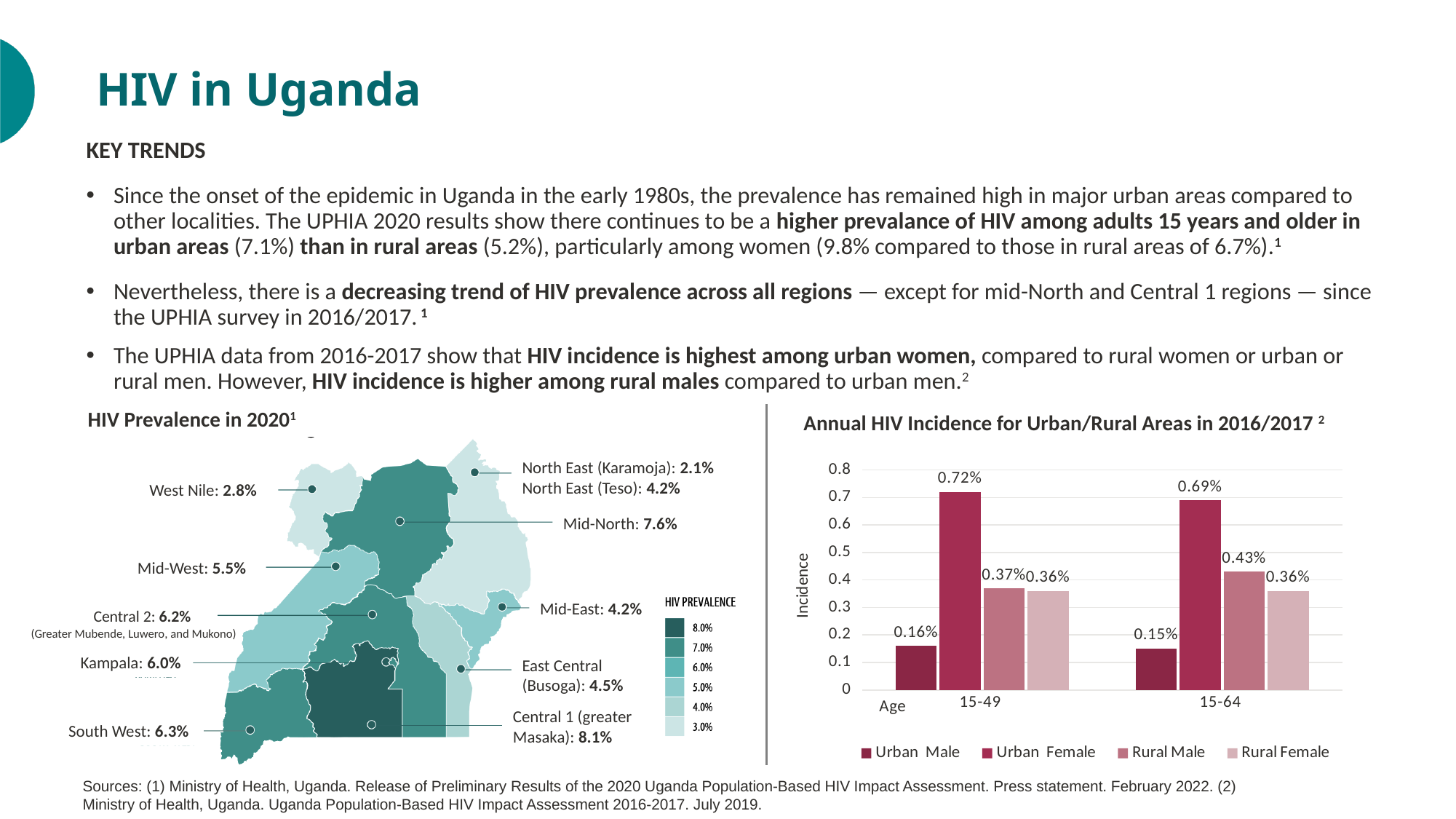
What kind of chart is the Annual HIV Incidence for Urban/Rural Areas in 2016/2017? Bar chart On the Annual HIV Incidence chart, what is the incidence for Urban Male in the 15-64 age group? 0.15% How many series does the legend of the Annual HIV Incidence chart list? 4 On the HIV Prevalence in 2020 map, what is the prevalence for Mid-North? 7.6% On the Annual HIV Incidence chart, is the incidence for Rural Male or Urban Male larger in the 15-64 age group? Rural Male On the Annual HIV Incidence chart, which series has the highest incidence in the 15-49 age group? Urban Female On the Annual HIV Incidence chart, what is the incidence for Rural Male in the 15-64 age group? 0.43% On the Annual HIV Incidence chart, what is the difference between Urban Female and Rural Male incidence in the 15-64 age group? 0.26% On the Annual HIV Incidence chart, what is the difference between Urban Female and Urban Male incidence in the 15-49 age group? 0.56% On the Annual HIV Incidence chart, is the Urban Female value for the 15-64 age group greater or less than 0.5? greater On the Annual HIV Incidence chart, which series has the lowest incidence in the 15-64 age group? Urban Male On the Annual HIV Incidence chart, what is the incidence for Urban Female in the 15-49 age group? 0.72%